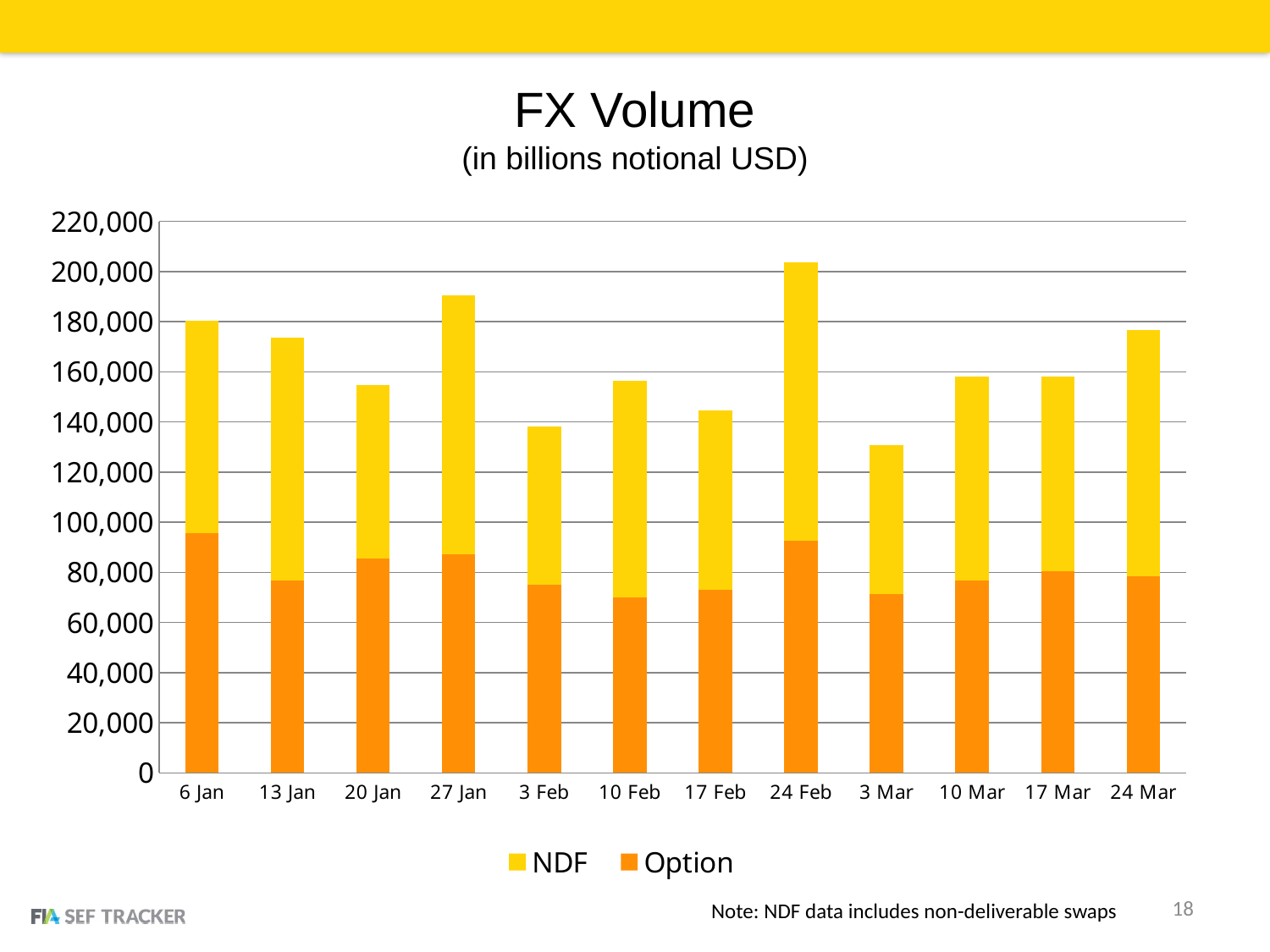
Does the total FX volume rise or fall from 3 Mar to 24 Mar? rise Which has the larger total FX volume, 27 Jan or 3 Feb? 27 Jan Which has the larger total FX volume, 6 Jan or 13 Jan? 6 Jan What kind of chart is shown on the slide? Stacked bar chart Is the total FX volume for 3 Mar greater or less than 140,000? less Which series is shown in orange in the legend? Option How many series does the legend list? 2 Is the total FX volume for 24 Feb greater or less than 200,000? greater Is the Option volume for 6 Jan greater or less than 100,000? less Which date has the lowest total FX volume? 3 Mar Which date has the highest total FX volume? 24 Feb How many weekly dates are shown on the x axis? 12